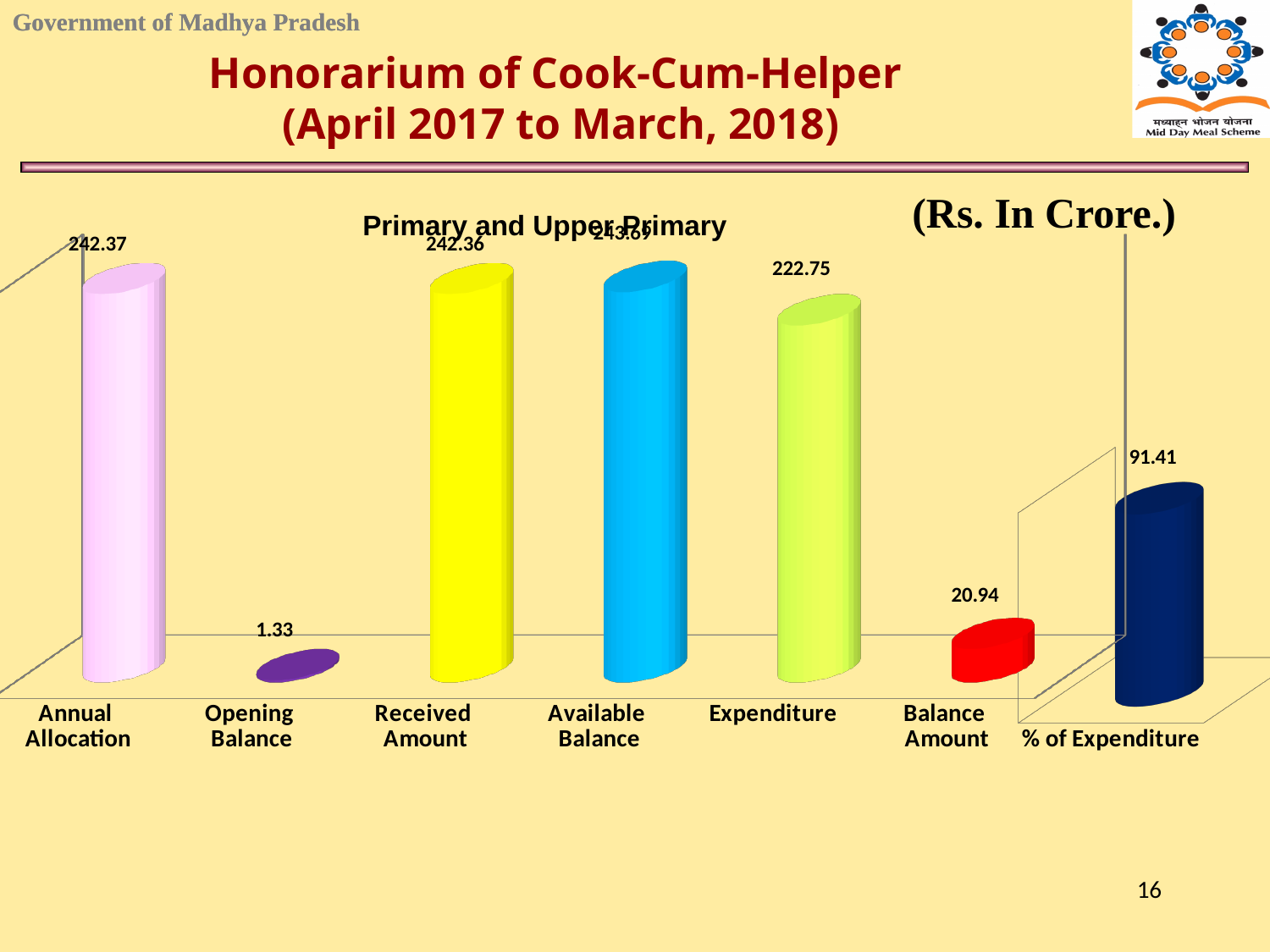
How many categories are shown on the x axis? 7 What is the difference between Expenditure and Balance Amount? 201.81 Which category has the lowest value? Opening Balance What is the value for Annual Allocation? 242.37 What is the value for Balance Amount? 20.94 What is the value for Expenditure? 222.75 What is the value for Opening Balance? 1.33 What is the value for Received Amount? 242.36 What kind of chart is shown? Bar chart Which is larger, Balance Amount or Opening Balance? Balance Amount What is the value for % of Expenditure? 91.41 What is the difference between Annual Allocation and Expenditure? 19.62